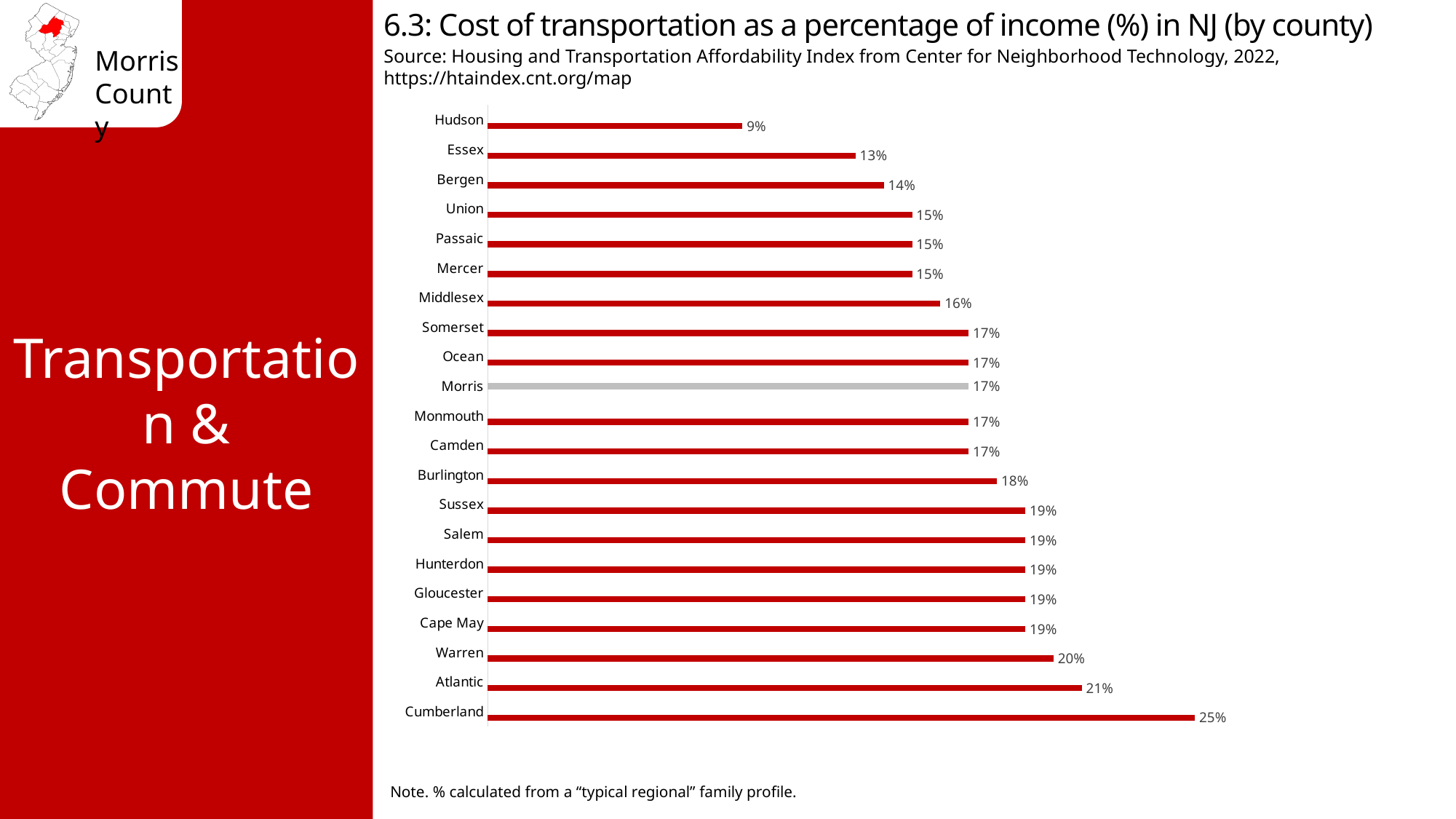
Which county has the highest cost of transportation as a percentage of income? Cumberland How many counties are shown in the chart? 21 Which has a higher value, Essex or Burlington? Burlington What is the value shown for Hudson? 9% Which county's bar is shown in grey instead of red? Morris What is the difference between the values for Cumberland and Hudson? 16% What is the value shown for Cumberland? 25% What is the value shown for Atlantic? 21% What type of chart is shown on the slide? Bar chart Which county has the lowest cost of transportation as a percentage of income? Hudson What is the difference between the values for Atlantic and Morris? 4% What is the cost of transportation as a percentage of income for Morris County? 17%